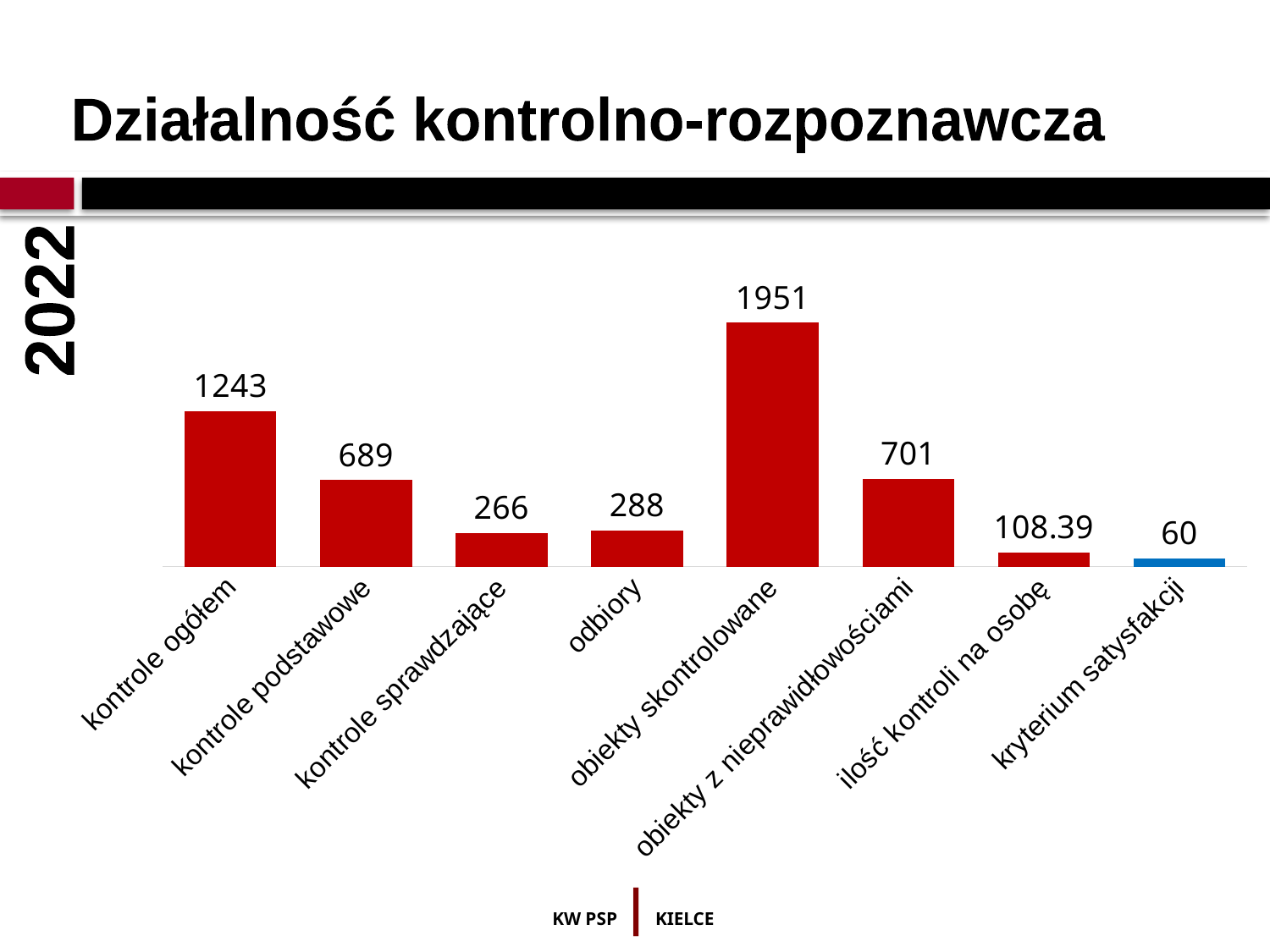
Which bar is shown in a different colour (blue) from the others? kryterium satysfakcji What is the value for kryterium satysfakcji? 60 What is the value for obiekty z nieprawidłowościami? 701 How many categories are shown in the chart? 8 Which category has the lowest value? kryterium satysfakcji What is the difference between kontrole ogółem and kontrole podstawowe? 554 What is the value for ilość kontroli na osobę? 108.39 What is the difference between obiekty skontrolowane and obiekty z nieprawidłowościami? 1250 What is the value for kontrole ogółem? 1243 Which is larger, odbiory or kontrole sprawdzające? odbiory Which category has the highest value? obiekty skontrolowane What kind of chart is shown on the slide? bar chart